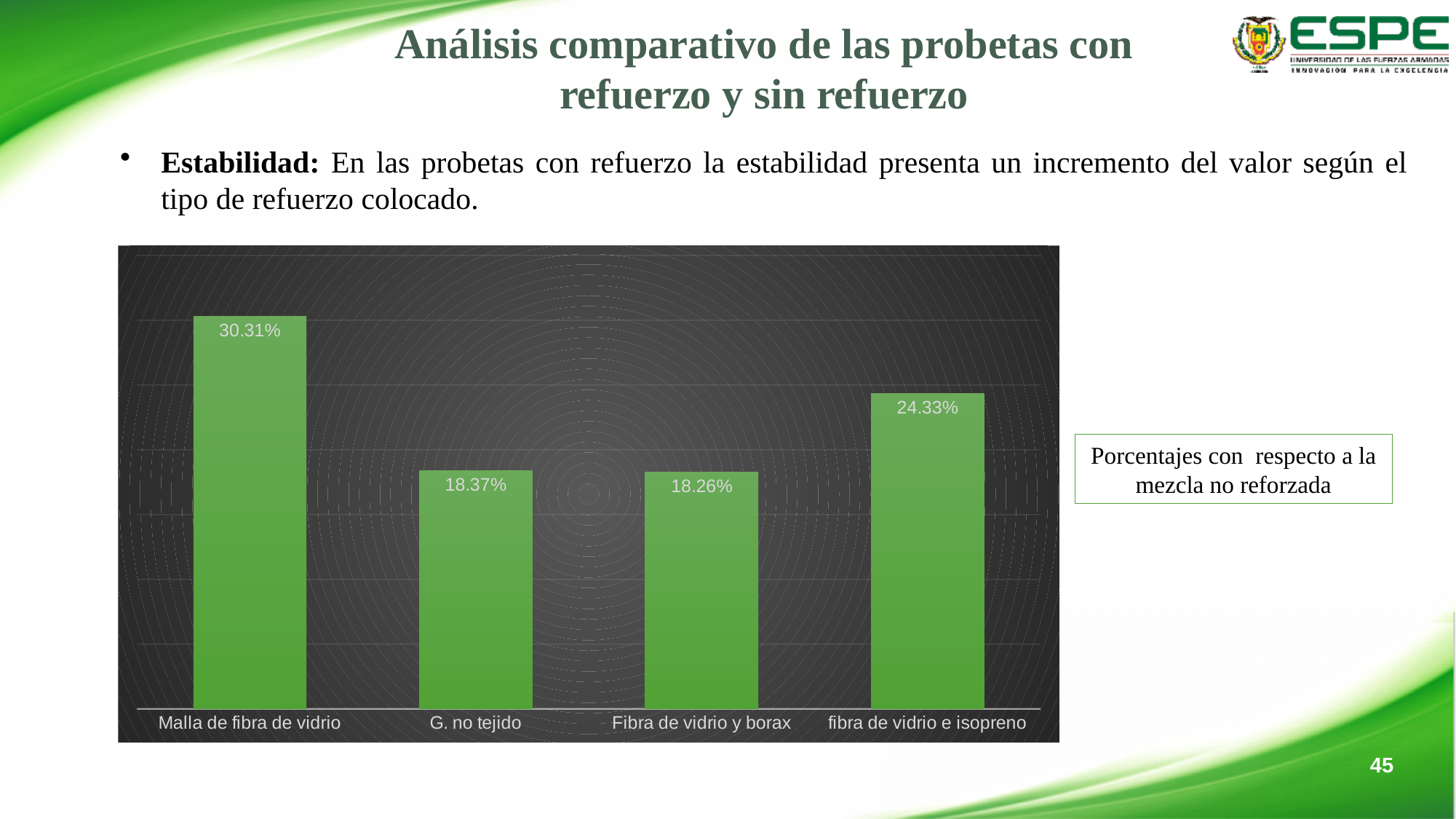
What is the difference between the values for fibra de vidrio e isopreno and Fibra de vidrio y borax? 6.07% Which is larger, the value for Malla de fibra de vidrio or the value for Fibra de vidrio y borax? Malla de fibra de vidrio How many categories are shown in the chart? 4 What is the value for fibra de vidrio e isopreno? 24.33% What is the value for G. no tejido? 18.37% What kind of chart is shown on the slide? Bar chart What is the difference between the values for Malla de fibra de vidrio and G. no tejido? 11.94% What is the value for Fibra de vidrio y borax? 18.26% Which is larger, the value for fibra de vidrio e isopreno or the value for G. no tejido? fibra de vidrio e isopreno What is the difference between the values for Malla de fibra de vidrio and fibra de vidrio e isopreno? 5.98% Which category has the highest value? Malla de fibra de vidrio What is the value for Malla de fibra de vidrio? 30.31%